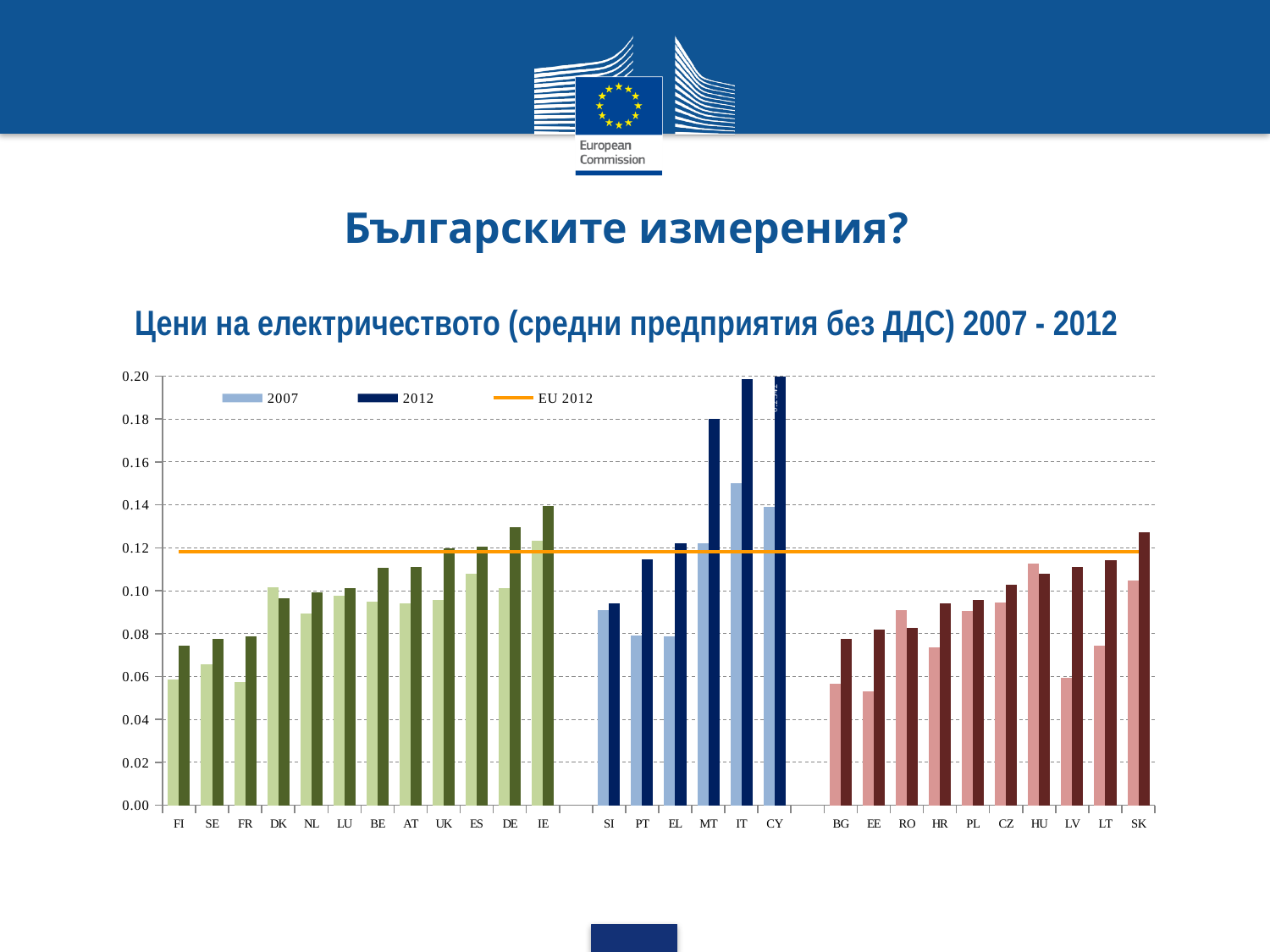
Is the 2012 value for MT greater or less than 0.16? greater What kind of chart is shown on the slide? bar chart Is the 2007 value for LV greater or less than 0.08? less Is the 2007 value for FI greater or less than 0.08? less Which is larger, the 2012 value for MT or the 2012 value for SK? MT How many series does the chart legend list? 3 How many countries are shown along the x axis of the chart? 28 Do the 2012 values rise or fall along the x axis from FI to IE? rise Which country has the highest 2007 value in the chart? IT What colour is the EU 2012 line in the chart? orange